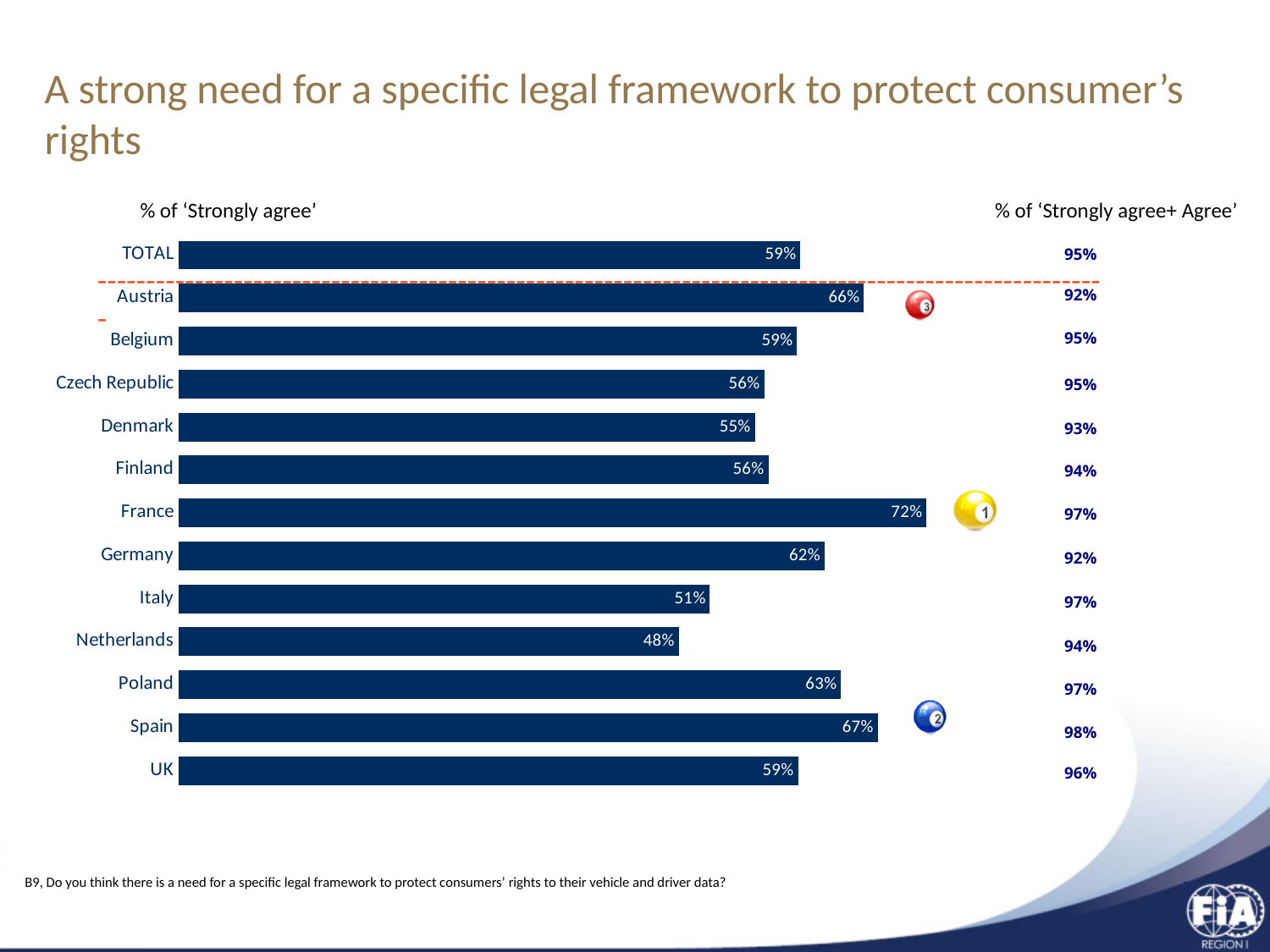
What is the '% of Strongly agree+ Agree' value shown for Denmark? 93% What is the '% of Strongly agree+ Agree' value shown for Spain? 98% What is the difference between the '% of Strongly agree' values for Spain and Italy? 16% Which country has the highest '% of Strongly agree' value? France Which country has the lowest '% of Strongly agree' value? Netherlands How many bars are shown in the chart, including TOTAL? 13 Which has a higher '% of Strongly agree' value, Austria or Germany? Austria Which country is marked with the number 2 ball next to its bar? Spain What is the '% of Strongly agree' value for the Netherlands? 48% What is the '% of Strongly agree' value for France? 72% What is the '% of Strongly agree' value for TOTAL? 59% What kind of chart is used to show the '% of Strongly agree' values? Bar chart